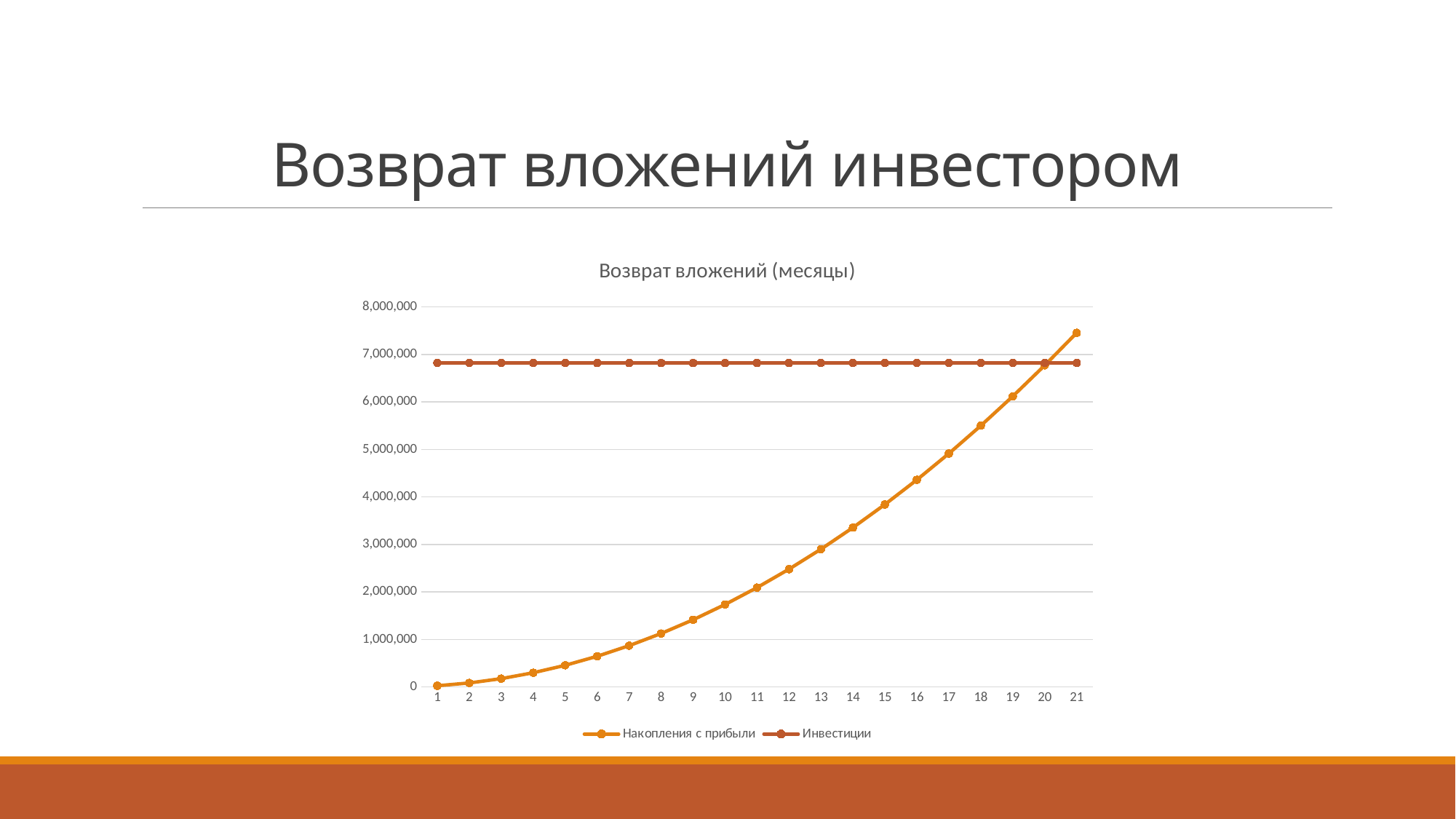
Does the 'Инвестиции' series rise, fall or stay flat across the months? stays flat Is the value of 'Накопления с прибыли' at month 10 greater or less than 2,000,000? less Is the value of 'Накопления с прибыли' at month 21 greater or less than 7,000,000? greater Does the 'Накопления с прибыли' series rise or fall as the months increase? rises How many months (points) are plotted along the x axis? 21 How many series does the legend list? 2 At month 15, which series has the higher value, 'Накопления с прибыли' or 'Инвестиции'? Инвестиции At month 21, which series has the higher value, 'Накопления с прибыли' or 'Инвестиции'? Накопления с прибыли Is the value of 'Инвестиции' greater or less than 6,000,000? greater What is the title of the chart? Возврат вложений (месяцы) What kind of chart is shown on the slide? line chart